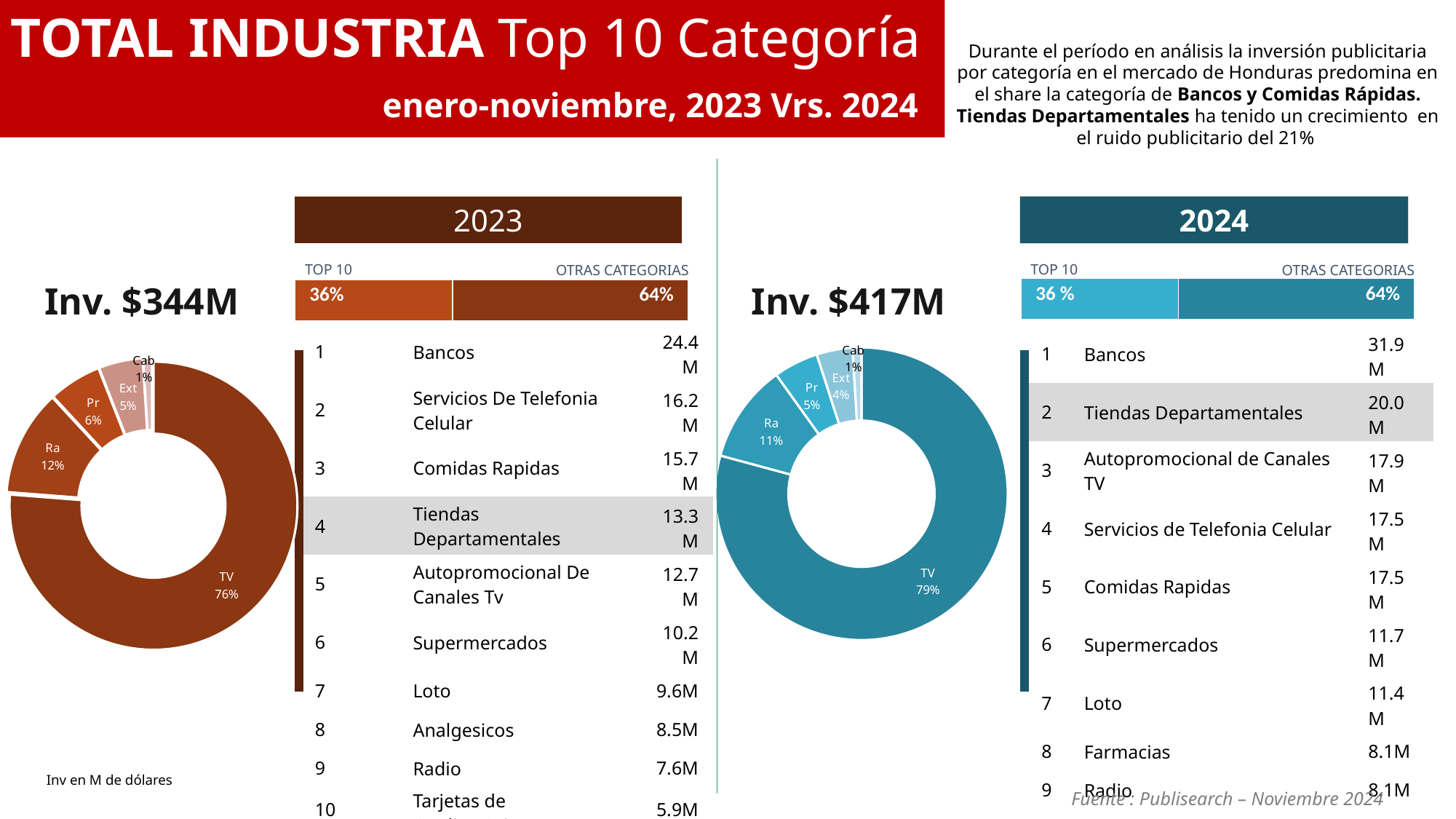
In the 2023 donut chart, what share does Ra have? 12% In the 2023 donut chart, what share does TV have? 76% In the 2024 donut chart, which segment is the smallest? Cab In the 2023 donut chart, which segment is the largest? TV What kind of chart is used to show the media shares for 2023 and 2024? Donut chart In the 2023 donut chart, which is larger, the Pr share or the Ext share? Pr In the 2024 donut chart, what share does TV have? 79% In the 2024 stacked bar, what share is labelled OTRAS CATEGORIAS? 64% In the 2023 stacked bar, what share is labelled TOP 10? 36% What is the difference between the TV share in the 2024 donut chart and the TV share in the 2023 donut chart? 3% How many segments does the 2024 donut chart have? 5 In the 2024 donut chart, what share does Ext have? 4%